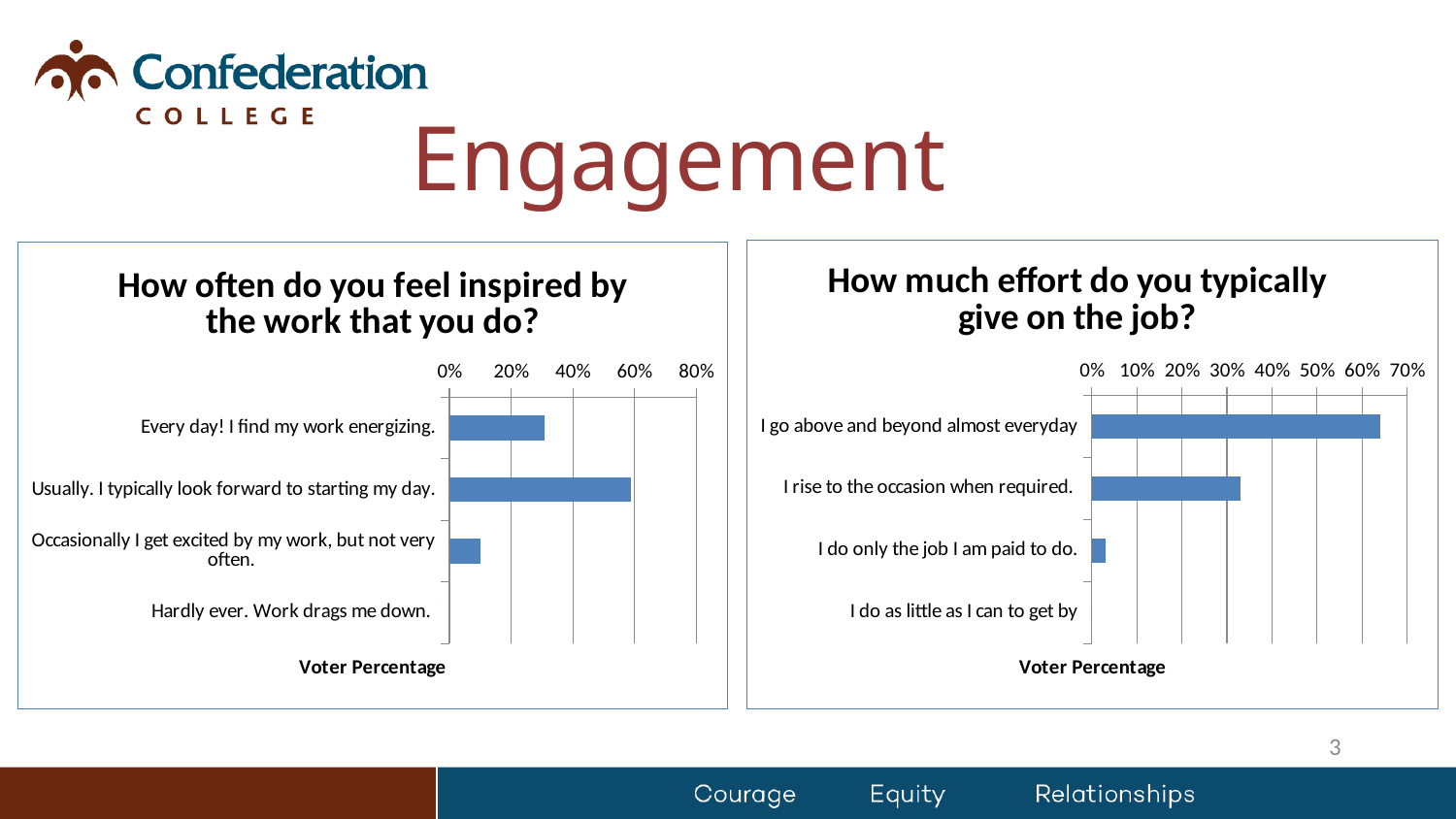
In the chart 'How much effort do you typically give on the job?', which is larger: 'I rise to the occasion when required.' or 'I do only the job I am paid to do.'? I rise to the occasion when required. In the chart 'How often do you feel inspired by the work that you do?', which category has the highest value? Usually. I typically look forward to starting my day. In the chart 'How much effort do you typically give on the job?', is the value for 'I go above and beyond almost everyday' greater or less than 60%? greater In the chart 'How often do you feel inspired by the work that you do?', is the value for 'Occasionally I get excited by my work, but not very often.' greater or less than 20%? less In the chart 'How often do you feel inspired by the work that you do?', is the value for 'Usually. I typically look forward to starting my day.' greater or less than 40%? greater In the chart 'How often do you feel inspired by the work that you do?', which category has the lowest value? Hardly ever. Work drags me down. In the chart 'How much effort do you typically give on the job?', which category has the highest value? I go above and beyond almost everyday In the chart 'How much effort do you typically give on the job?', how many categories are shown? 4 What type of chart is 'How often do you feel inspired by the work that you do?'? bar chart In the chart 'How often do you feel inspired by the work that you do?', how many categories are shown? 4 What is the axis title shown below the bars in the chart 'How much effort do you typically give on the job?'? Voter Percentage